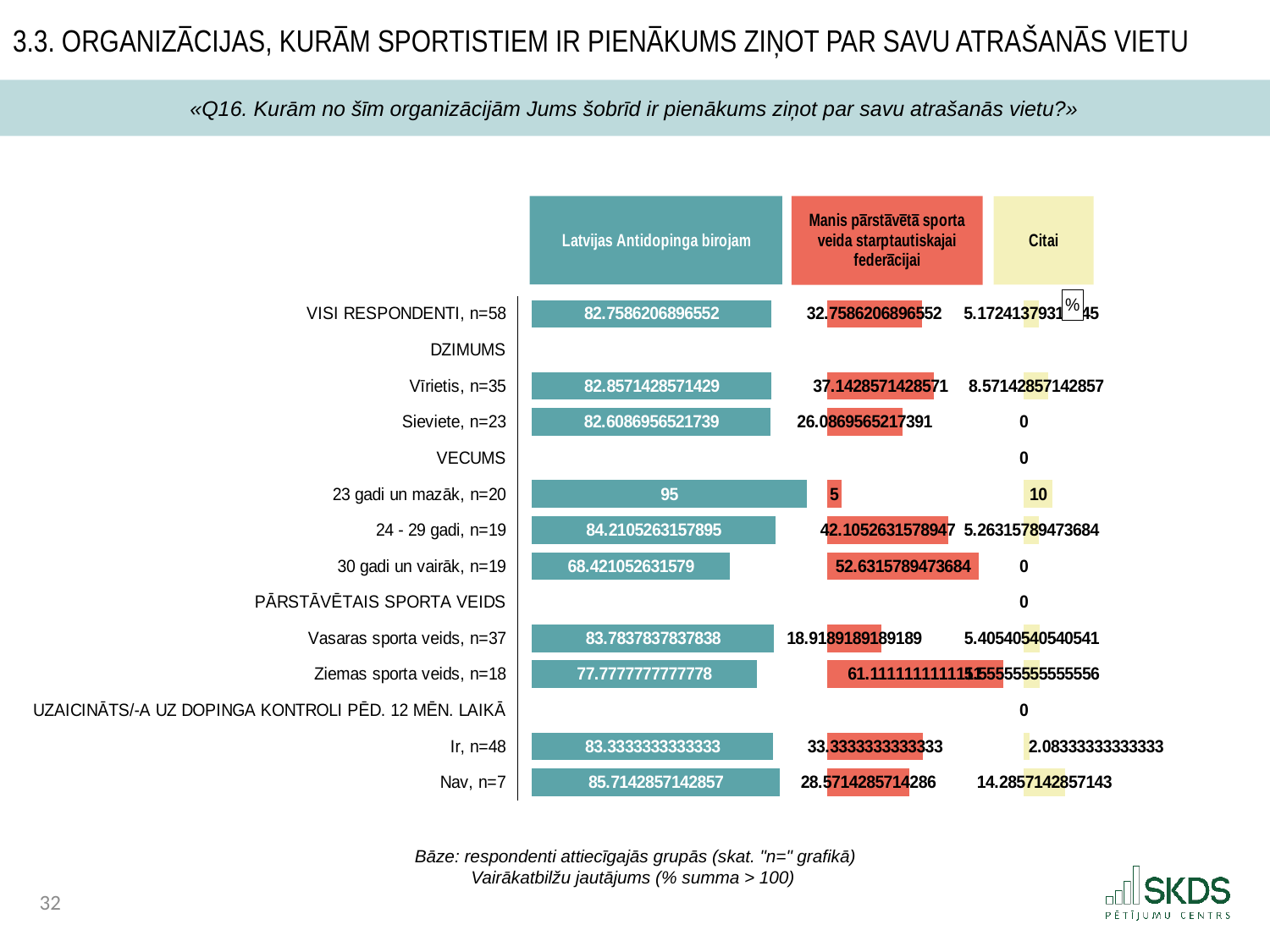
In the "Manis pārstāvētā sporta veida starptautiskajai federācijai" series, which is larger: "Vīrietis, n=35" or "Sieviete, n=23"? Vīrietis, n=35 How many series does the chart show? 3 For "23 gadi un mazāk, n=20", what is the difference between the "Latvijas Antidopinga birojam" value and the "Manis pārstāvētā sporta veida starptautiskajai federācijai" value? 90 What is the value for "30 gadi un vairāk, n=19" in the "Latvijas Antidopinga birojam" series? 68.421052631579 What is the total of the three series values for "23 gadi un mazāk, n=20"? 110 Which respondent group has the highest value in the "Manis pārstāvētā sporta veida starptautiskajai federācijai" series? Ziemas sporta veids, n=18 What kind of chart is shown on the slide? Bar chart What is the value for "23 gadi un mazāk, n=20" in the "Citai" series? 10 Which respondent group has the lowest value in the "Latvijas Antidopinga birojam" series? 30 gadi un vairāk, n=19 Which respondent group has the highest value in the "Latvijas Antidopinga birojam" series? 23 gadi un mazāk, n=20 What is the value for "23 gadi un mazāk, n=20" in the "Latvijas Antidopinga birojam" series? 95 What is the value for "Sieviete, n=23" in the "Citai" series? 0